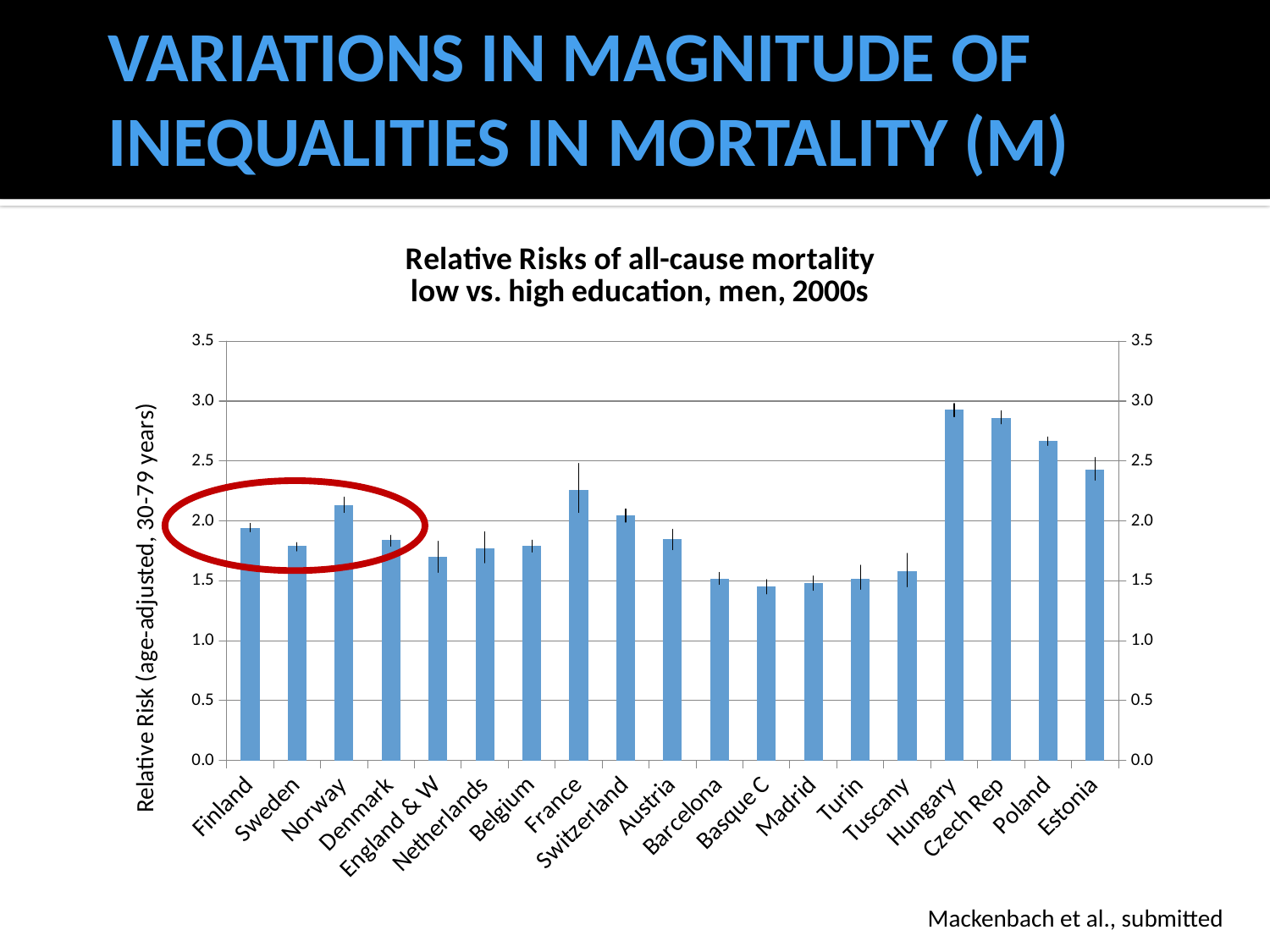
Is the value for Norway greater or less than 2.0? greater What is the label on the vertical axis of the chart? Relative Risk (age-adjusted, 30-79 years) What is the title of the chart? Relative Risks of all-cause mortality low vs. high education, men, 2000s Which country has the highest relative risk in the chart? Hungary Is the value for Poland greater or less than 2.5? greater Is the value for Sweden greater or less than 2.0? less How many countries or regions are plotted on the x axis of the chart? 19 Which has the larger relative risk, Poland or Estonia? Poland Which has the larger relative risk, France or Belgium? France What kind of chart is shown on the slide? bar chart